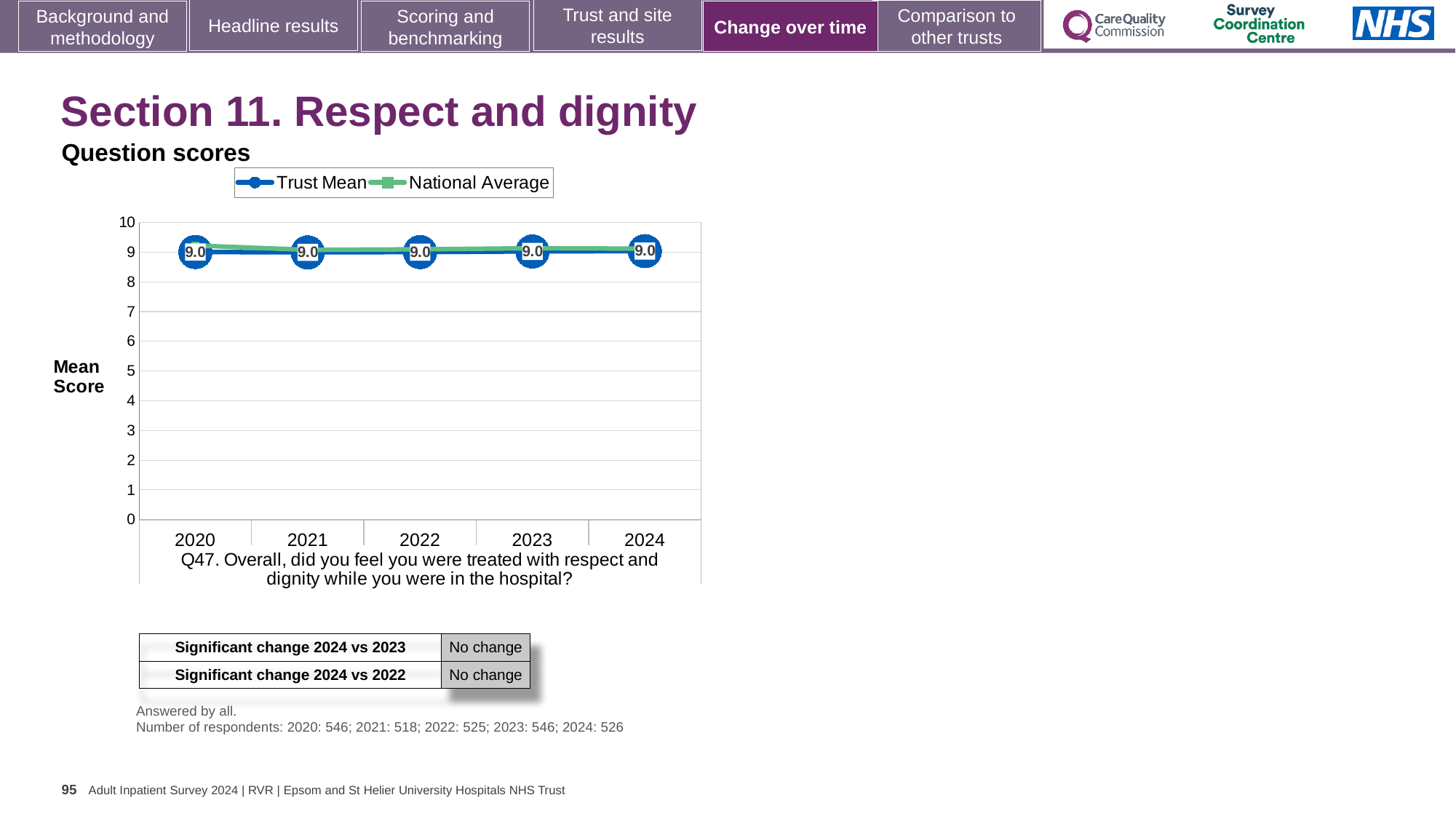
Does the Trust Mean score rise, fall or stay flat from 2020 to 2024? Stays flat Is the National Average score for 2021 greater or less than 8? greater What is the label of the y axis? Mean Score What kind of chart is shown? Line chart What is the Trust Mean score for 2020? 9.0 What is the Trust Mean score for 2024? 9.0 Which series is shown in green in the legend? National Average How many years are plotted on the x axis? 5 What is the Trust Mean score for 2022? 9.0 What is the difference between the Trust Mean score in 2024 and in 2020? 0.0 Is the Trust Mean score for 2023 greater or less than 5? greater How many series does the legend list? 2